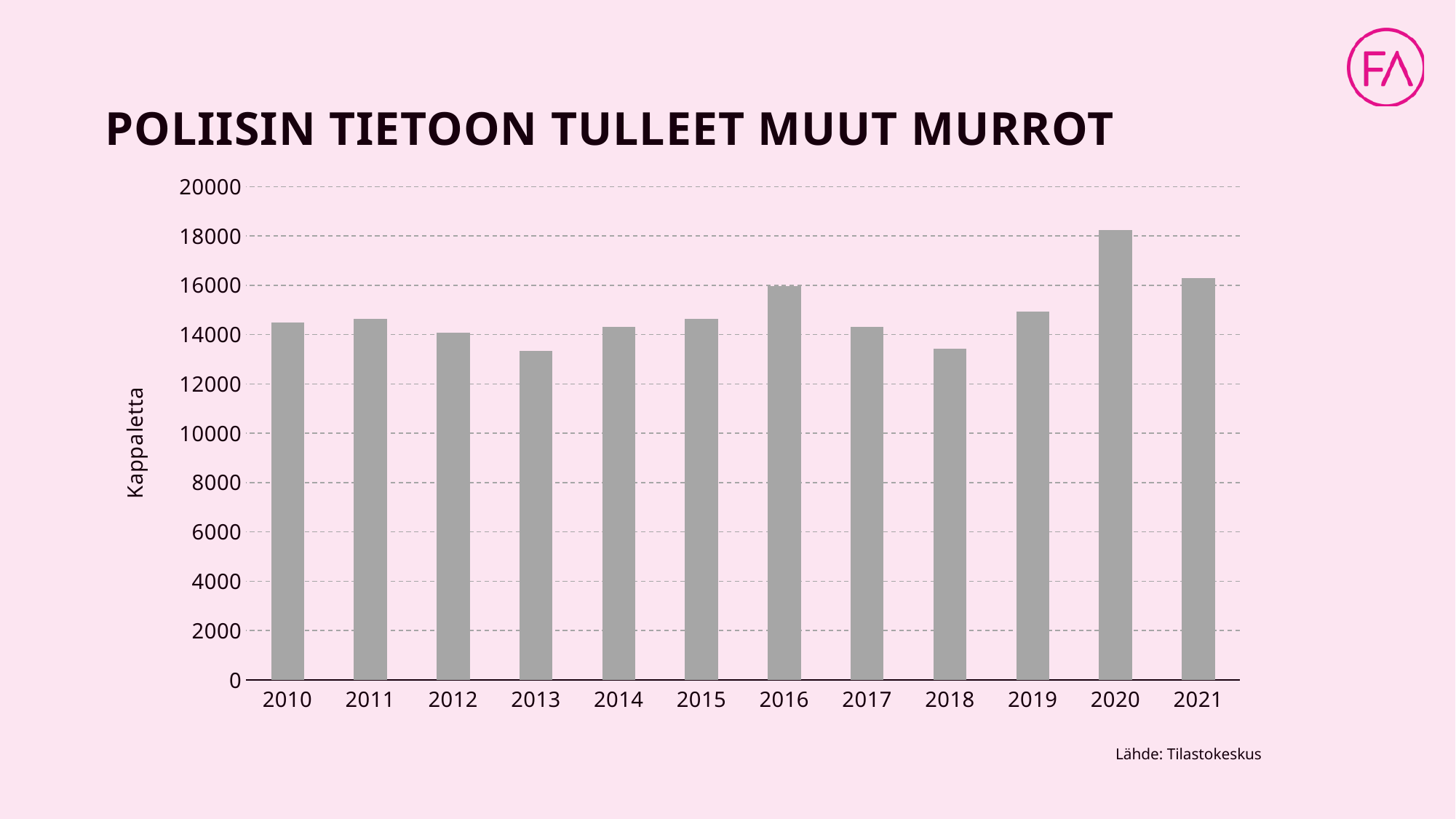
Is the value for 2019 greater or less than 16000? less Which year has the larger value, 2020 or 2021? 2020 Is the value for 2021 greater or less than 16000? greater Is the value for 2020 greater or less than 16000? greater Which year has the larger value, 2013 or 2016? 2016 Do the values rise or fall from 2018 to 2020? rise Which year has the highest number of reported break-ins in the chart? 2020 What kind of chart is shown on the slide? bar chart What is the label on the y axis of the chart? Kappaletta How many years are shown on the x axis of the chart? 12